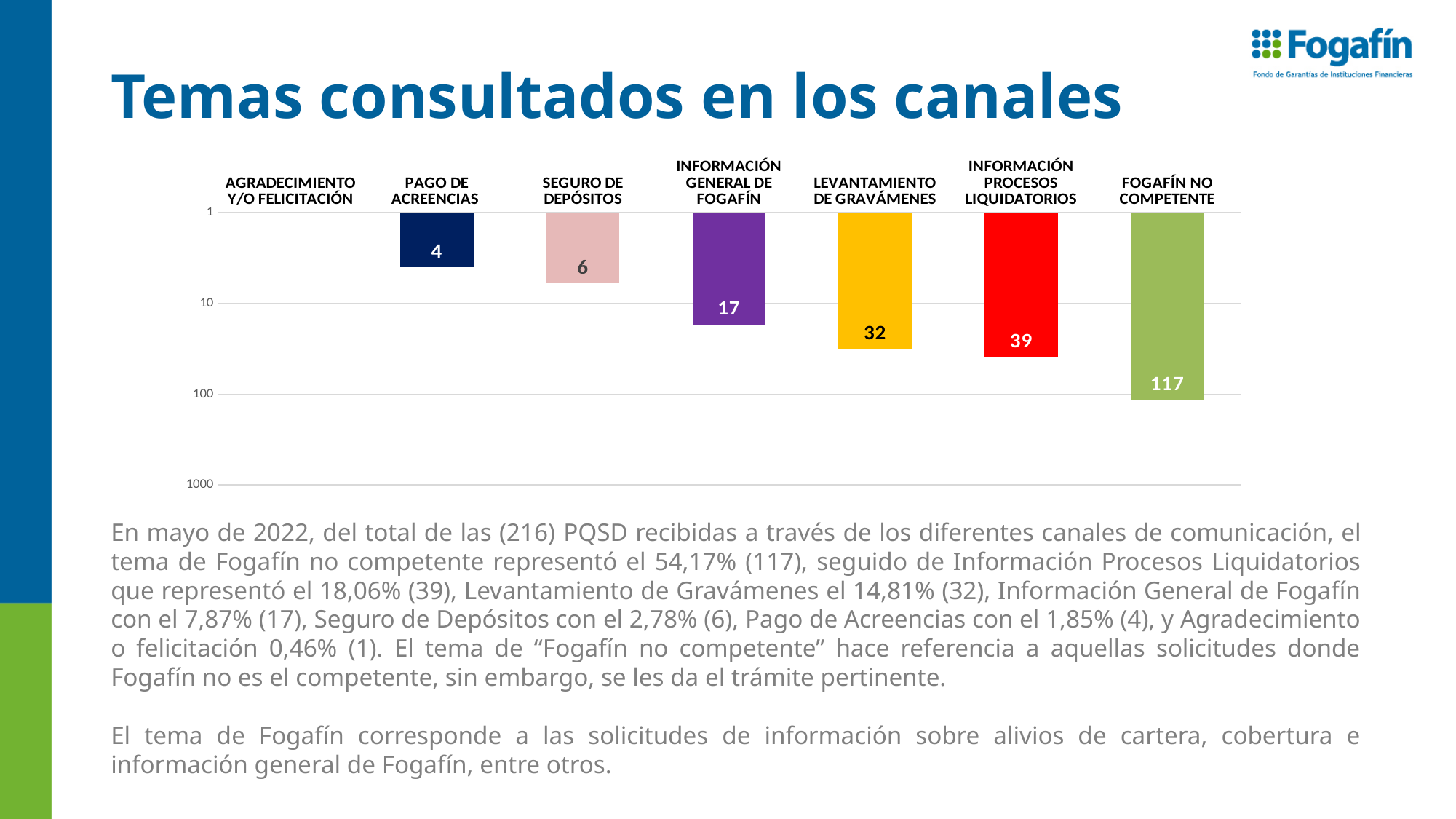
How many categories are shown on the chart's x axis? 7 Which category has the highest value? FOGAFÍN NO COMPETENTE What kind of chart is shown on the slide? bar chart Is the value for FOGAFÍN NO COMPETENTE greater or less than 100? greater What is the difference between the values for FOGAFÍN NO COMPETENTE and INFORMACIÓN PROCESOS LIQUIDATORIOS? 78 What is the value for LEVANTAMIENTO DE GRAVÁMENES? 32 What is the value for INFORMACIÓN PROCESOS LIQUIDATORIOS? 39 What is the value for SEGURO DE DEPÓSITOS? 6 Which is larger, the value for LEVANTAMIENTO DE GRAVÁMENES or the value for INFORMACIÓN PROCESOS LIQUIDATORIOS? INFORMACIÓN PROCESOS LIQUIDATORIOS What is the value for PAGO DE ACREENCIAS? 4 What is the difference between the values for INFORMACIÓN GENERAL DE FOGAFÍN and SEGURO DE DEPÓSITOS? 11 What is the value for FOGAFÍN NO COMPETENTE? 117